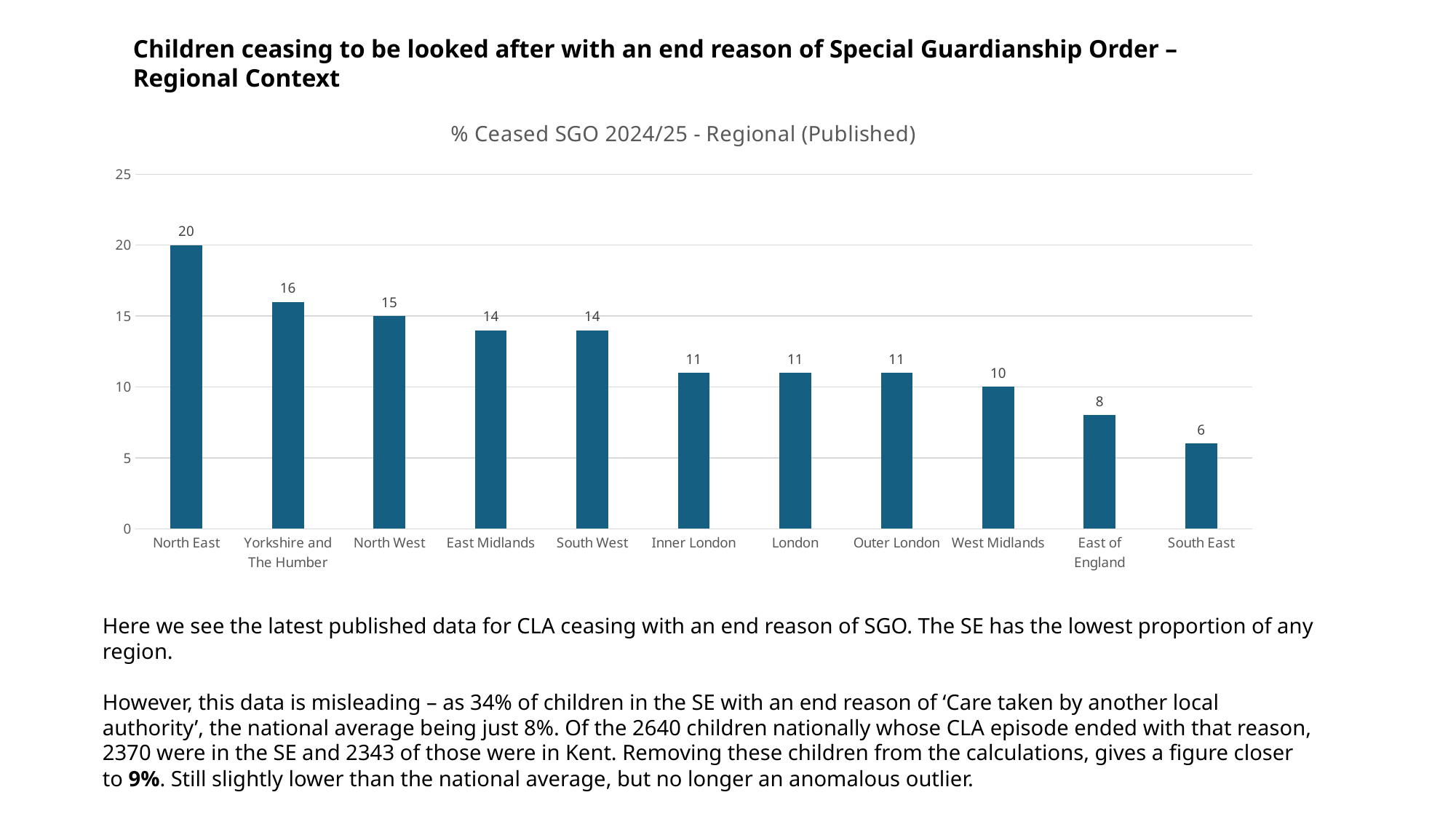
What is the value for East of England? 8 What kind of chart is this? Bar chart What is the difference between the values for North East and South East? 14 What is the title of the chart? % Ceased SGO 2024/25 - Regional (Published) How many regions are shown on the chart? 11 Which is larger, the value for East Midlands or the value for Inner London? East Midlands Which region has the highest value? North East What is the value for West Midlands? 10 What is the value for Yorkshire and The Humber? 16 What is the value for North East? 20 Which region has the lowest value? South East What is the difference between the values for North West and West Midlands? 5